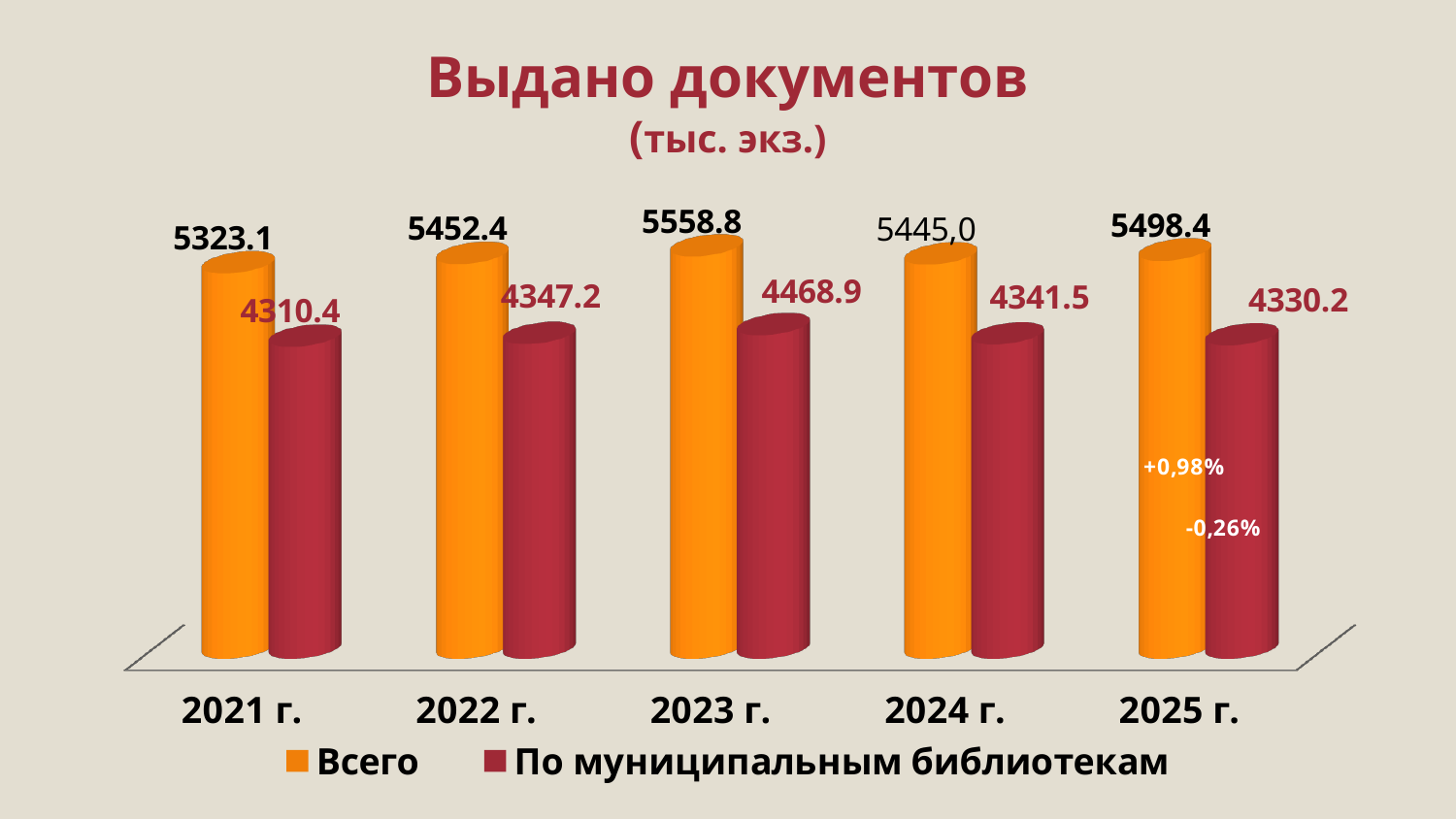
What is the value for "По муниципальным библиотекам" in 2023 г.? 4468.9 How many years are shown on the x axis? 5 Which is larger: the "Всего" value in 2022 г. or in 2025 г.? 2025 г. In which year is the "Всего" value the highest? 2023 г. What is the value for "Всего" in 2021 г.? 5323.1 What kind of chart is shown on the slide? Bar chart How many series does the legend list? 2 What is the value for "Всего" in 2024 г.? 5445,0 What is the difference between the "Всего" values for 2025 г. and 2024 г.? 53.4 What is the value for "По муниципальным библиотекам" in 2025 г.? 4330.2 What is the difference between "Всего" and "По муниципальным библиотекам" in 2023 г.? 1089.9 In which year is the "По муниципальным библиотекам" value the lowest? 2021 г.